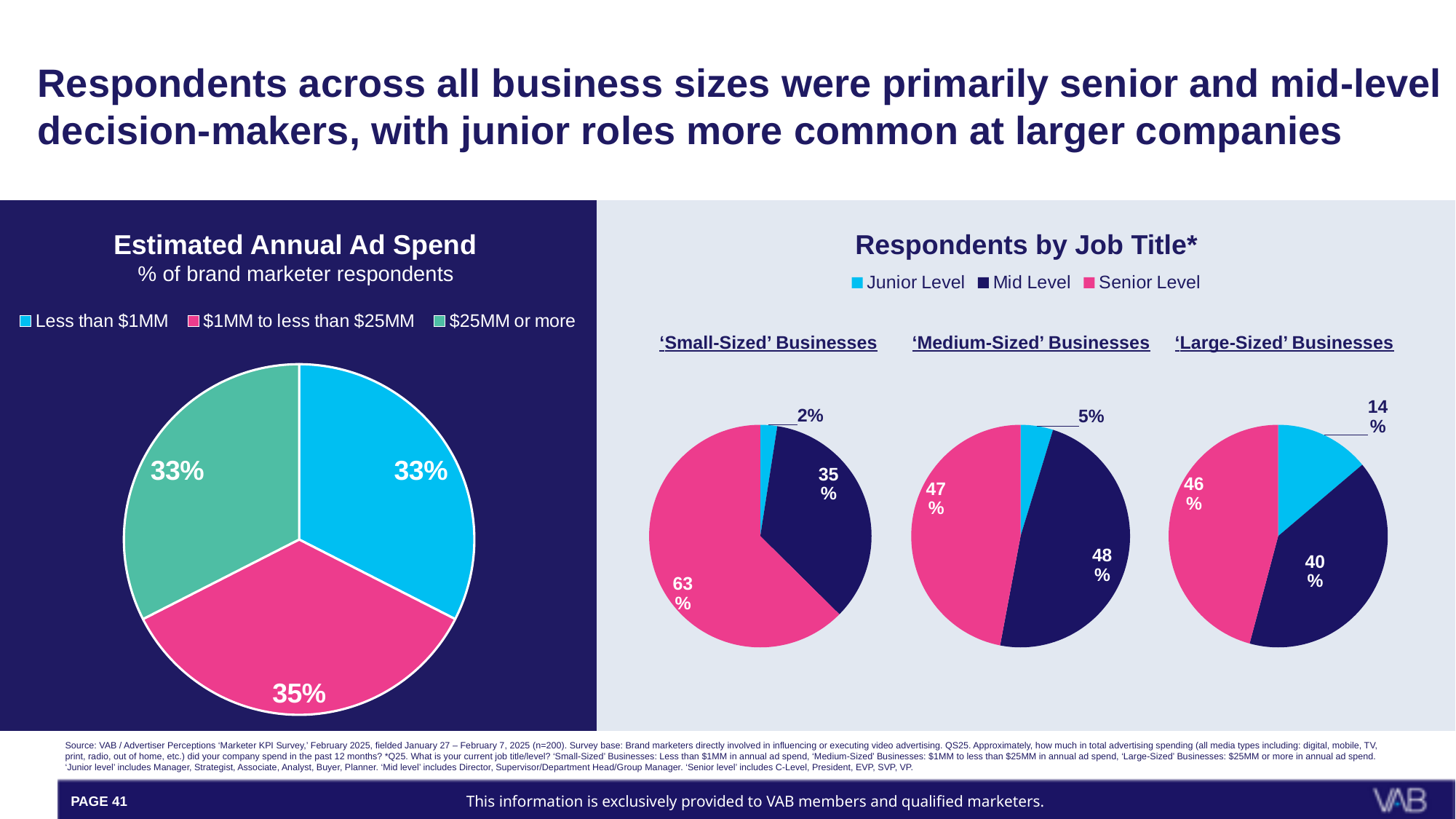
In the 'Small-Sized' Businesses pie, what is the difference between the Senior Level and Mid Level shares? 28 percentage points What type of chart is used for 'Estimated Annual Ad Spend'? Pie chart In the 'Small-Sized' Businesses pie, what percentage of respondents are Junior Level? 2% In the 'Large-Sized' Businesses pie, what percentage of respondents are Junior Level? 14% How many pie charts are shown under 'Respondents by Job Title'? 3 Which has a larger Junior Level share: 'Medium-Sized' Businesses or 'Large-Sized' Businesses? 'Large-Sized' Businesses In the 'Medium-Sized' Businesses pie, what percentage of respondents are Mid Level? 48% In the 'Estimated Annual Ad Spend' chart, which ad spend category has the largest share? $1MM to less than $25MM How many series does the legend of the 'Respondents by Job Title' charts list? 3 In the 'Estimated Annual Ad Spend' chart, what share of respondents spend $1MM to less than $25MM? 35% In the 'Small-Sized' Businesses pie, what percentage of respondents are Senior Level? 63% In the 'Large-Sized' Businesses pie, which job level has the largest share? Senior Level